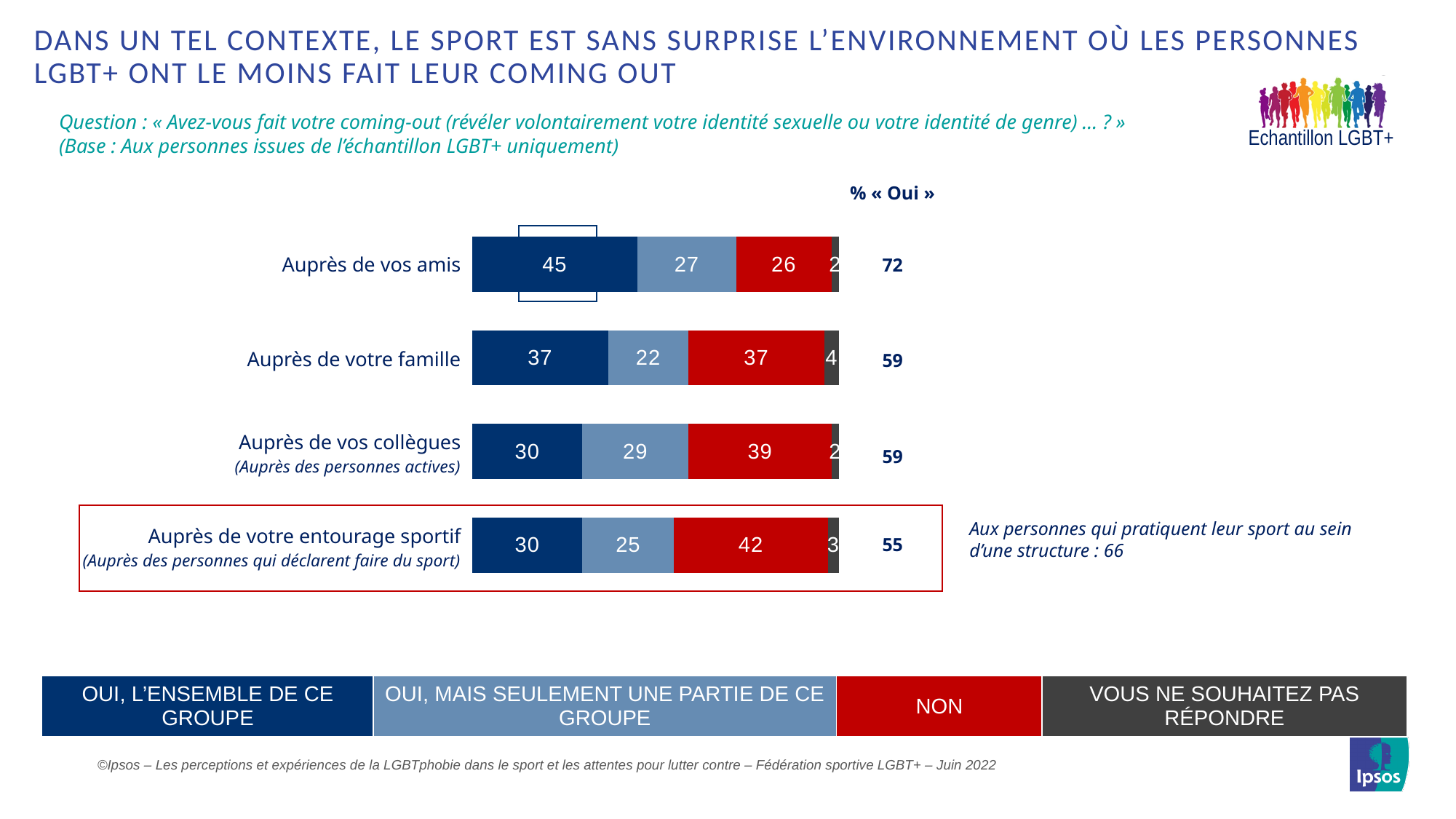
Which colour represents "Non" in the chart? Red What is the "% « Oui »" figure shown for "Auprès de votre famille"? 59 How many categories are shown in the chart? 4 How many series does the legend list? 4 Which category has the lowest "% « Oui »" figure? Auprès de votre entourage sportif What kind of chart is shown on the slide? Stacked bar chart What is the value for "Oui, mais seulement une partie de ce groupe" for "Auprès de vos collègues"? 29 Which is larger: the "Non" value for "Auprès de votre famille" or for "Auprès de vos collègues"? Auprès de vos collègues Which category has the highest "% « Oui »" figure? Auprès de vos amis What is the value for "Oui, l'ensemble de ce groupe" for "Auprès de vos amis"? 45 What is the difference between the "Non" values for "Auprès de votre entourage sportif" and "Auprès de vos amis"? 16 What is the "Non" value for "Auprès de votre entourage sportif"? 42